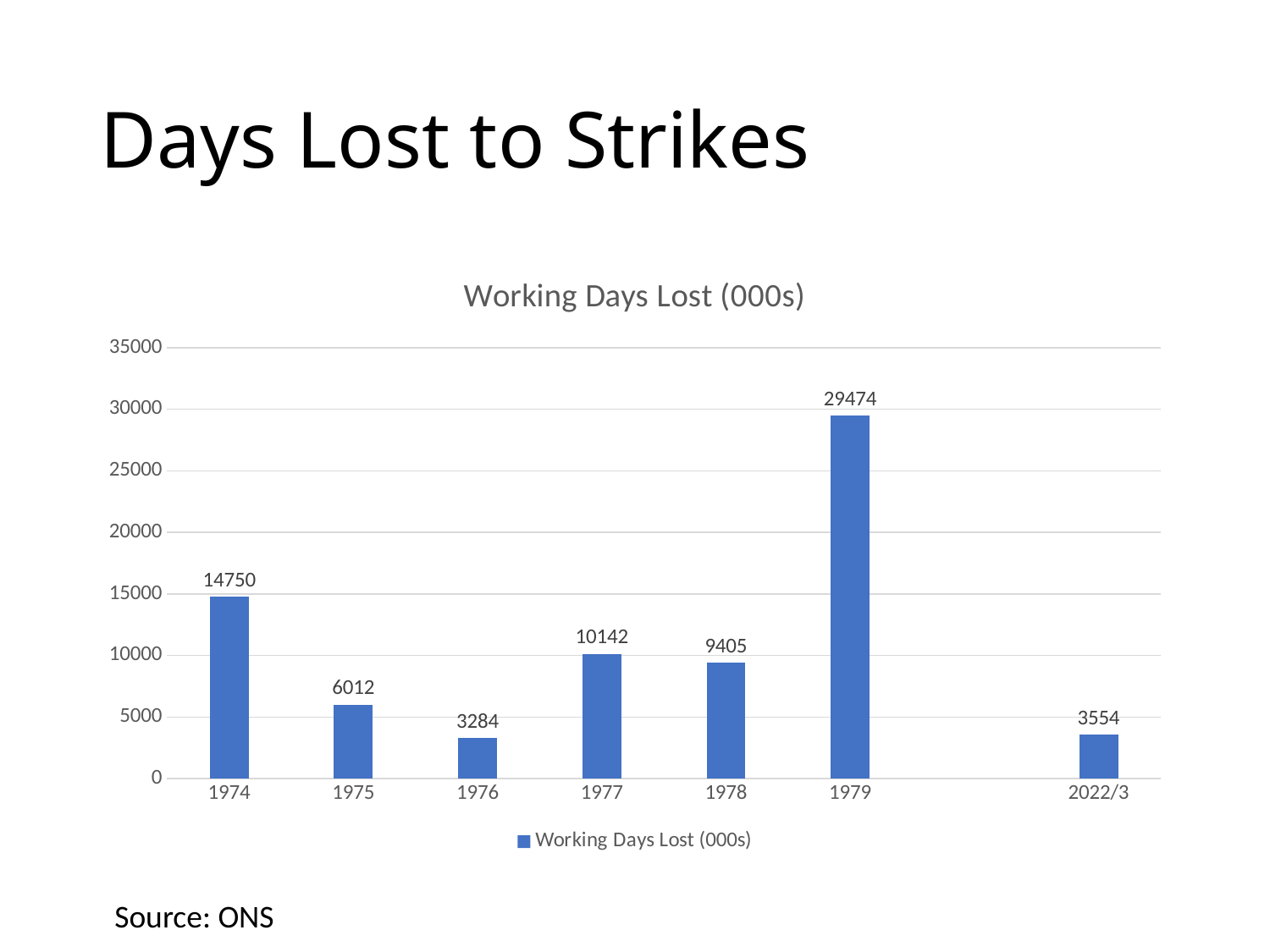
Which year has the lowest number of working days lost? 1976 What is the value for 1974? 14750 What is the value for 2022/3? 3554 What is the difference between the values for 1977 and 1978? 737 Which year has the highest number of working days lost? 1979 What is the value for 1979? 29474 Is the value for 1978 greater or less than 10000? less How many categories are shown on the x axis? 7 What kind of chart is shown on the slide? bar chart What is the title of the chart? Working Days Lost (000s) What is the difference between the values for 1979 and 1974? 14724 Which is larger, the value for 1975 or the value for 2022/3? 1975